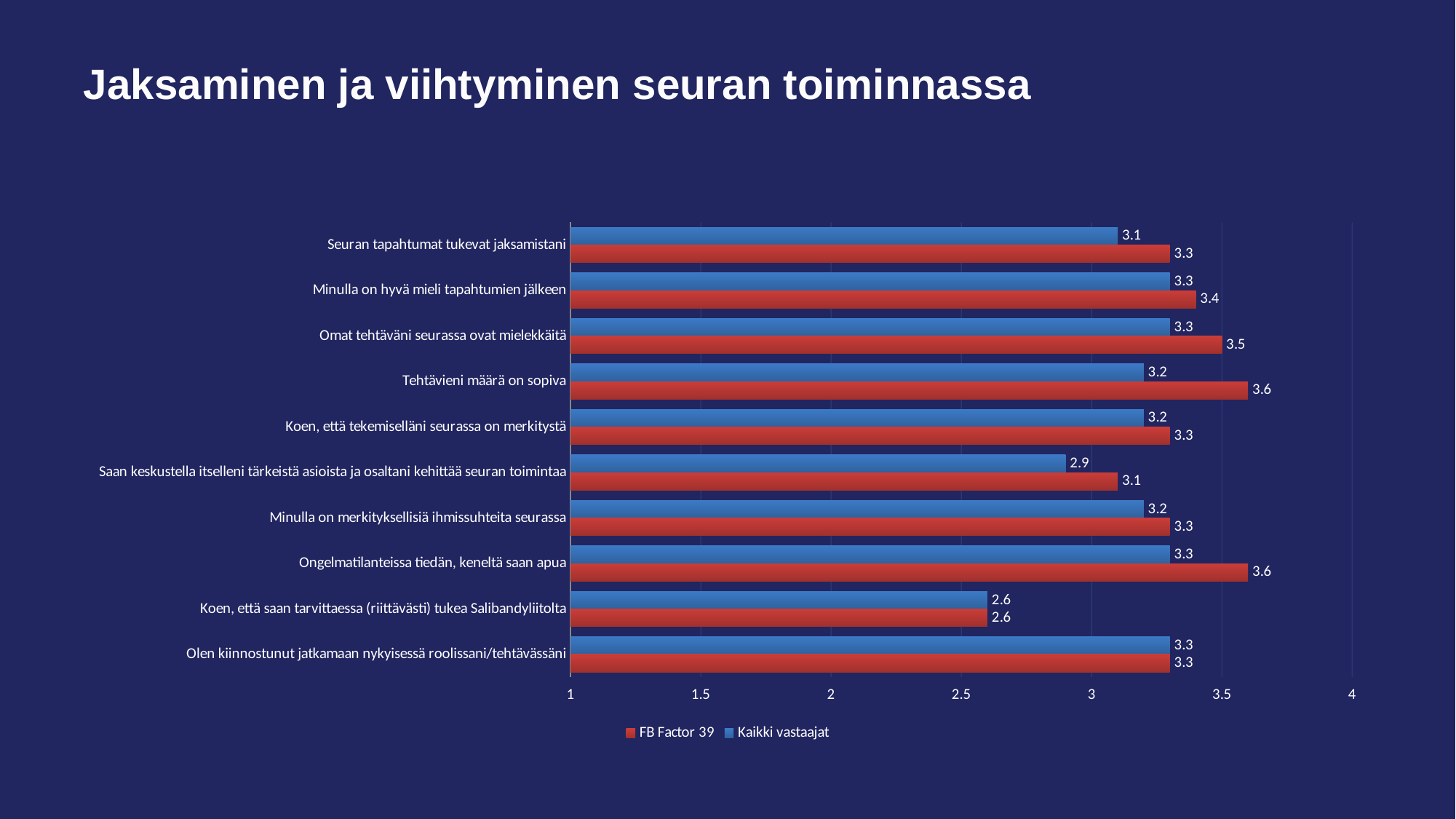
What is the FB Factor 39 value for "Tehtävieni määrä on sopiva"? 3.6 Which statement has the lowest FB Factor 39 value? Koen, että saan tarvittaessa (riittävästi) tukea Salibandyliitolta How many series does the legend list? 2 Is the Kaikki vastaajat value for "Seuran tapahtumat tukevat jaksamistani" greater or less than 3? greater What is the Kaikki vastaajat value for "Saan keskustella itselleni tärkeistä asioista ja osaltani kehittää seuran toimintaa"? 2.9 What is the FB Factor 39 value for "Omat tehtäväni seurassa ovat mielekkäitä"? 3.5 How many categories (statements) are shown in the chart? 10 Which series is shown in red in the chart? FB Factor 39 For "Ongelmatilanteissa tiedän, keneltä saan apua", which series has the larger value, FB Factor 39 or Kaikki vastaajat? FB Factor 39 What kind of chart is shown on the slide? bar chart What is the difference between the FB Factor 39 and Kaikki vastaajat values for "Tehtävieni määrä on sopiva"? 0.4 Which statement has the lowest Kaikki vastaajat value? Koen, että saan tarvittaessa (riittävästi) tukea Salibandyliitolta